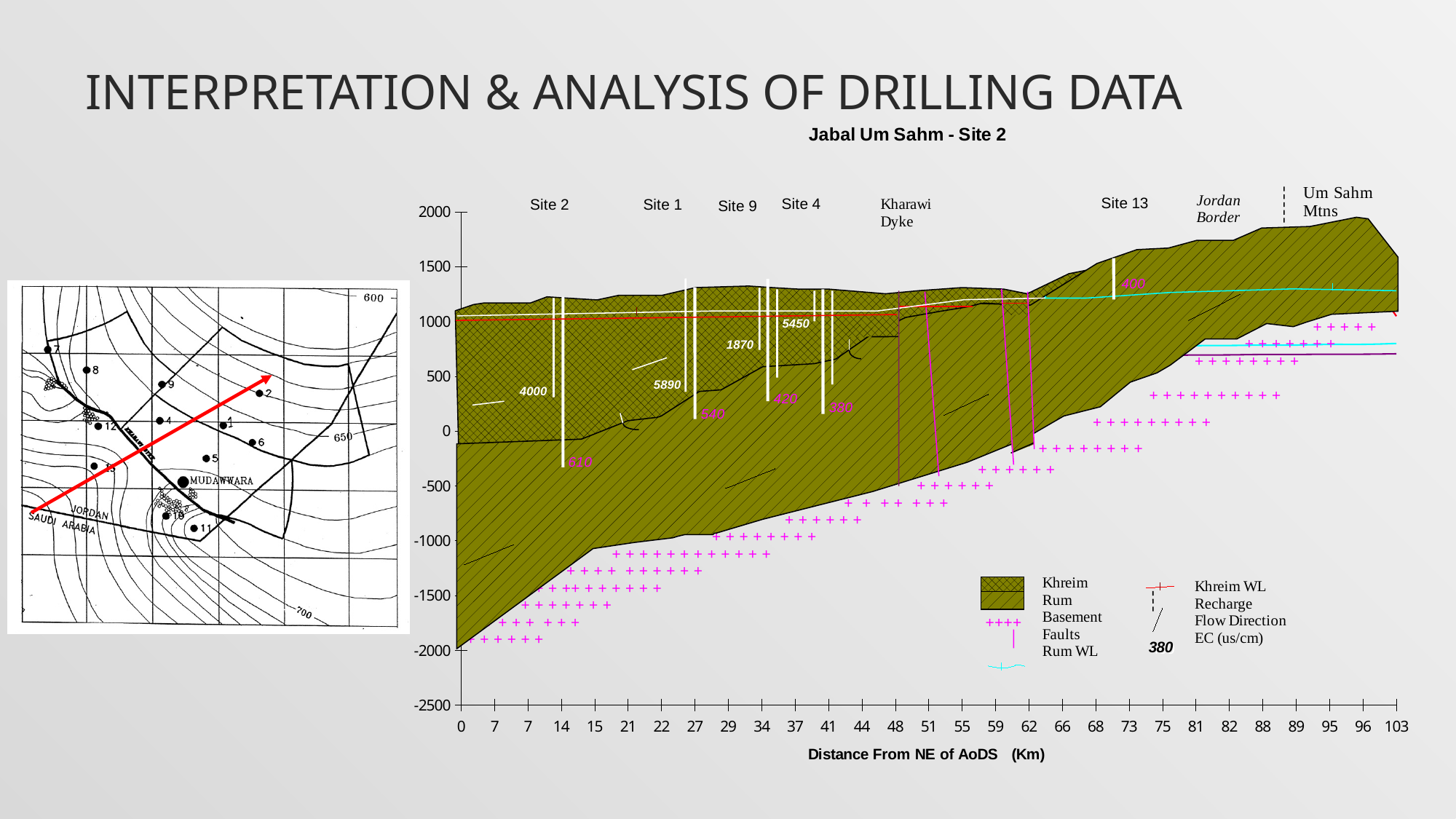
What is the title of the cross-section chart? Jabal Um Sahm - Site 2 How many numbered sites (Site labels) are marked along the top of the cross-section? 5 Which labelled site has the highest printed EC value on the cross-section? Site 1 What is the label of the x axis of the cross-section chart? Distance From NE of AoDS (Km) What EC value (us/cm) is printed at the Site 13 well on the cross-section? 400